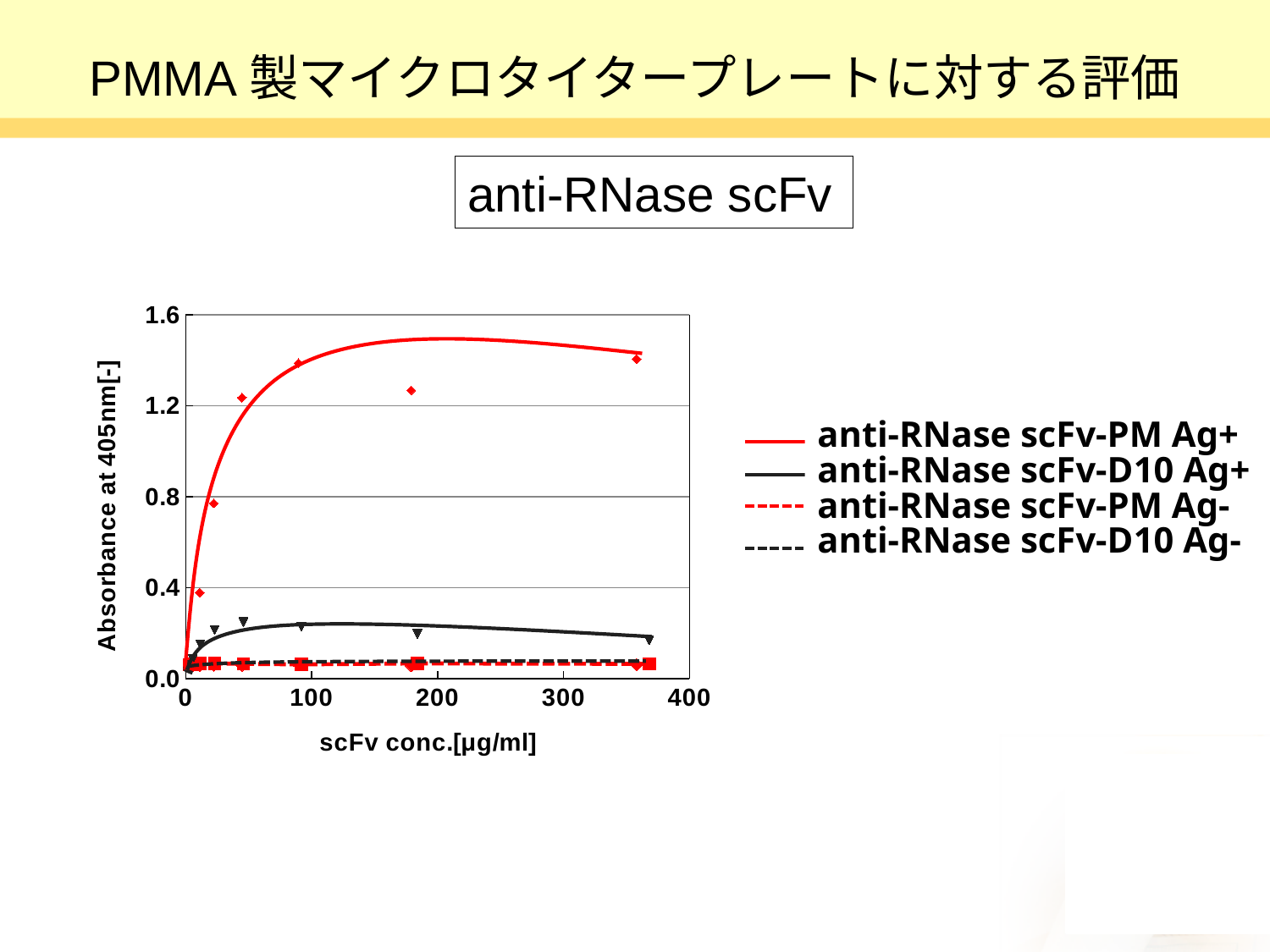
What is the highest value shown on the y axis? 1.6 How many series does the legend list? 4 At about 180 μg/ml, which series has the higher absorbance: anti-RNase scFv-PM Ag+ or anti-RNase scFv-D10 Ag+? anti-RNase scFv-PM Ag+ What is the label of the x axis? scFv conc.[μg/ml] Which series is drawn as a solid red line? anti-RNase scFv-PM Ag+ Is the absorbance for anti-RNase scFv-PM Ag- at about 360 μg/ml greater or less than 0.4? less Is the absorbance for anti-RNase scFv-D10 Ag+ at about 180 μg/ml greater or less than 0.4? less Which series reaches the highest absorbance values? anti-RNase scFv-PM Ag+ Does the absorbance for anti-RNase scFv-PM Ag+ rise or fall as scFv concentration increases from 0 to 100 μg/ml? rise What kind of chart is shown on the slide? line chart with data points (scatter with fitted curves) Is the absorbance for anti-RNase scFv-PM Ag+ at about 360 μg/ml greater or less than 1.2? greater